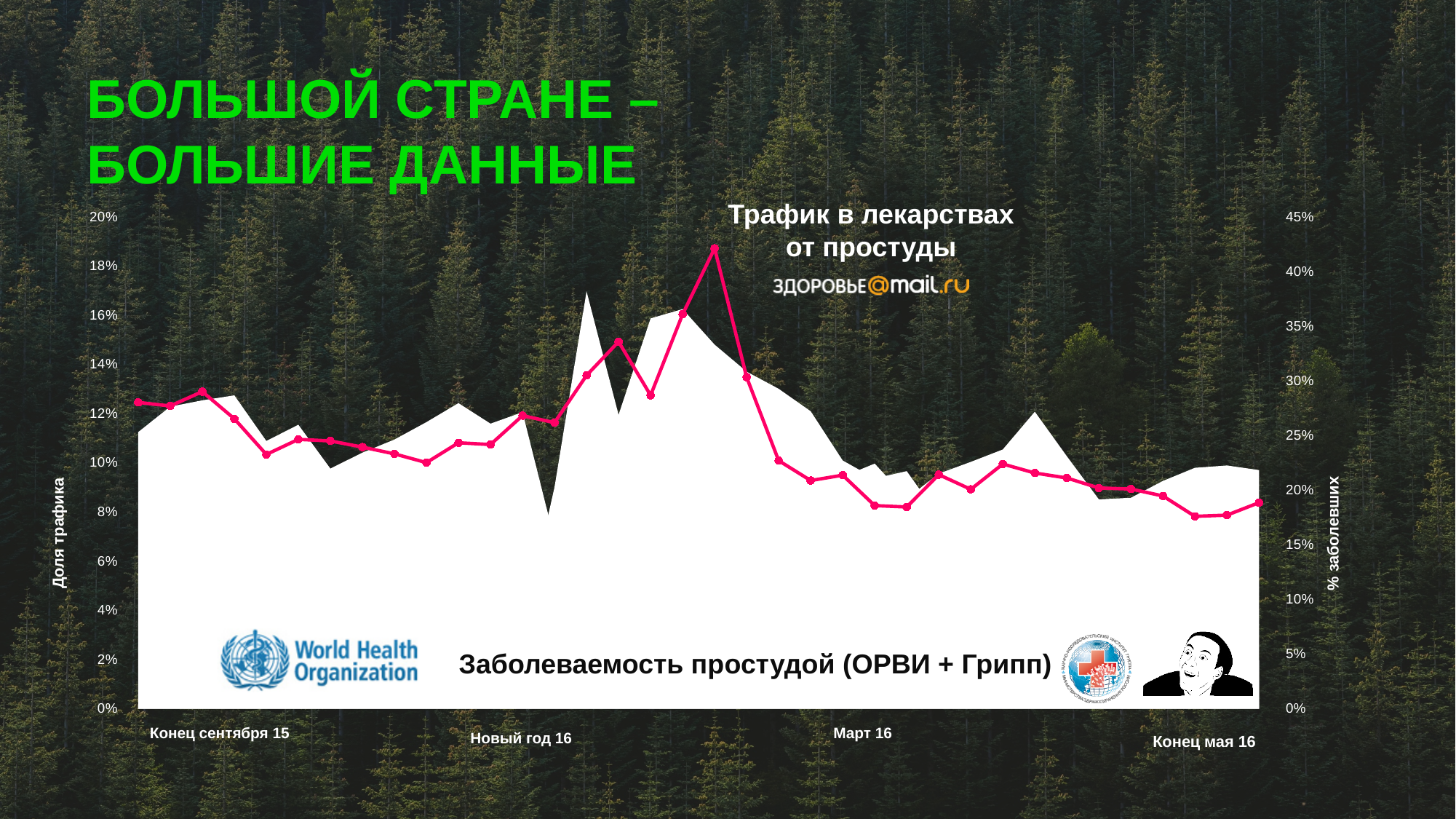
Is the peak of the white area (Заболеваемость простудой) greater or less than 35% on the right axis? greater Is the value of the pink line at Конец сентября 15 greater or less than 10% on the left axis? greater What is the title of the left vertical axis? Доля трафика Between which two x-axis labels does the pink line reach its highest point? Новый год 16 and Март 16 What is the highest value shown on the right vertical axis? 45% Is the peak value of the pink line (Трафик в лекарствах от простуды) greater or less than 16% on the left axis? greater What is the title of the right vertical axis? % заболевших Does the pink line generally rise or fall from its peak to Конец мая 16? fall What kind of chart is shown on the slide? A line chart with a shaded area series How many labels are shown along the x axis? 4